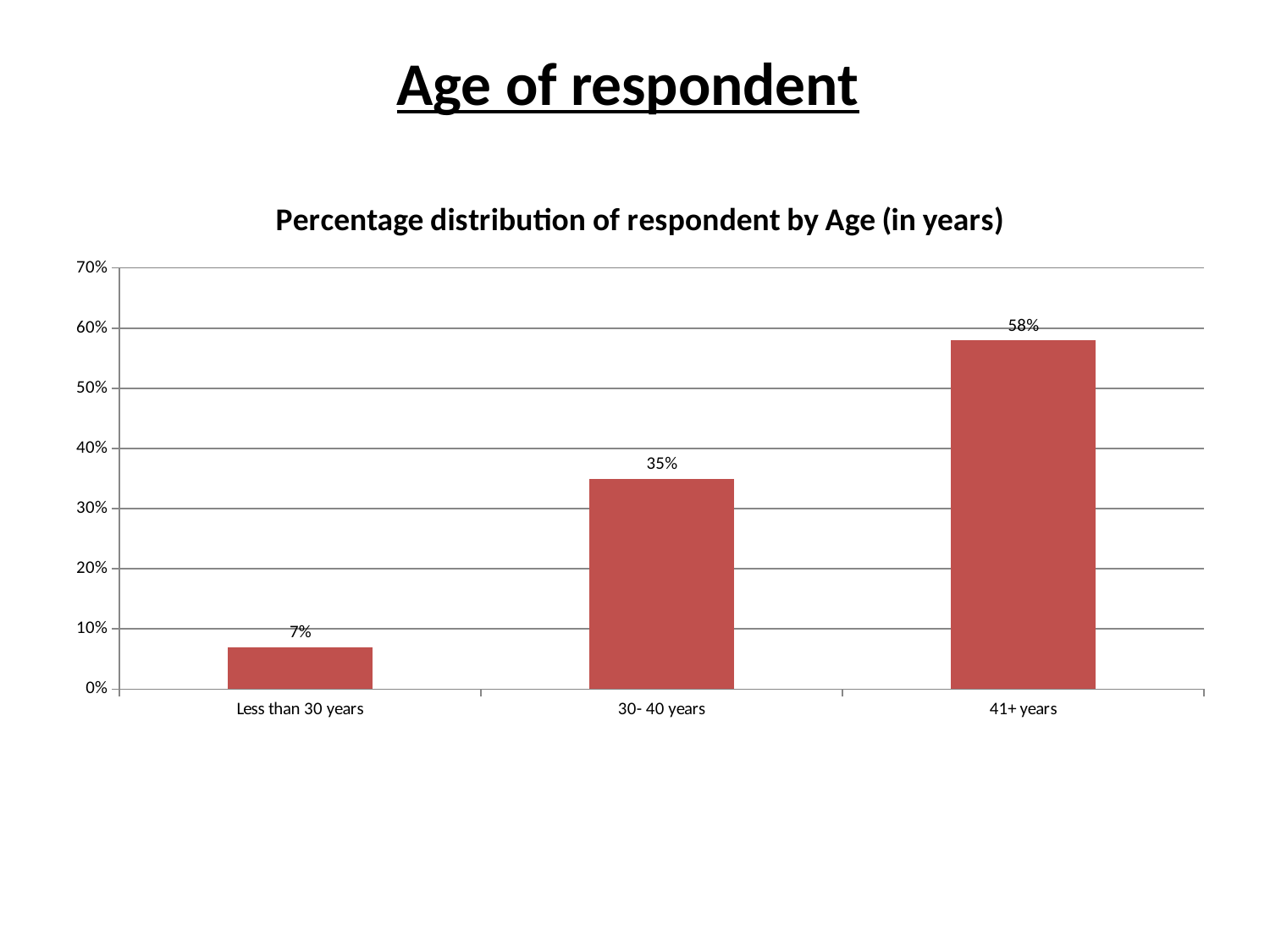
What type of chart is shown on the slide? Bar chart Which is larger, the value for 30- 40 years or the value for Less than 30 years? 30- 40 years Which age category has the highest percentage of respondents? 41+ years What is the difference between the 30- 40 years and Less than 30 years percentages? 28% What is the difference between the 41+ years and 30- 40 years percentages? 23% What percentage of respondents are less than 30 years old? 7% Is the value for 41+ years greater or less than 50%? greater Which age category has the lowest percentage of respondents? Less than 30 years What percentage of respondents are 41+ years? 58% What is the value for the 30- 40 years category? 35% Do the values rise or fall from left to right across the age categories? Rise How many age categories are shown in the chart? 3